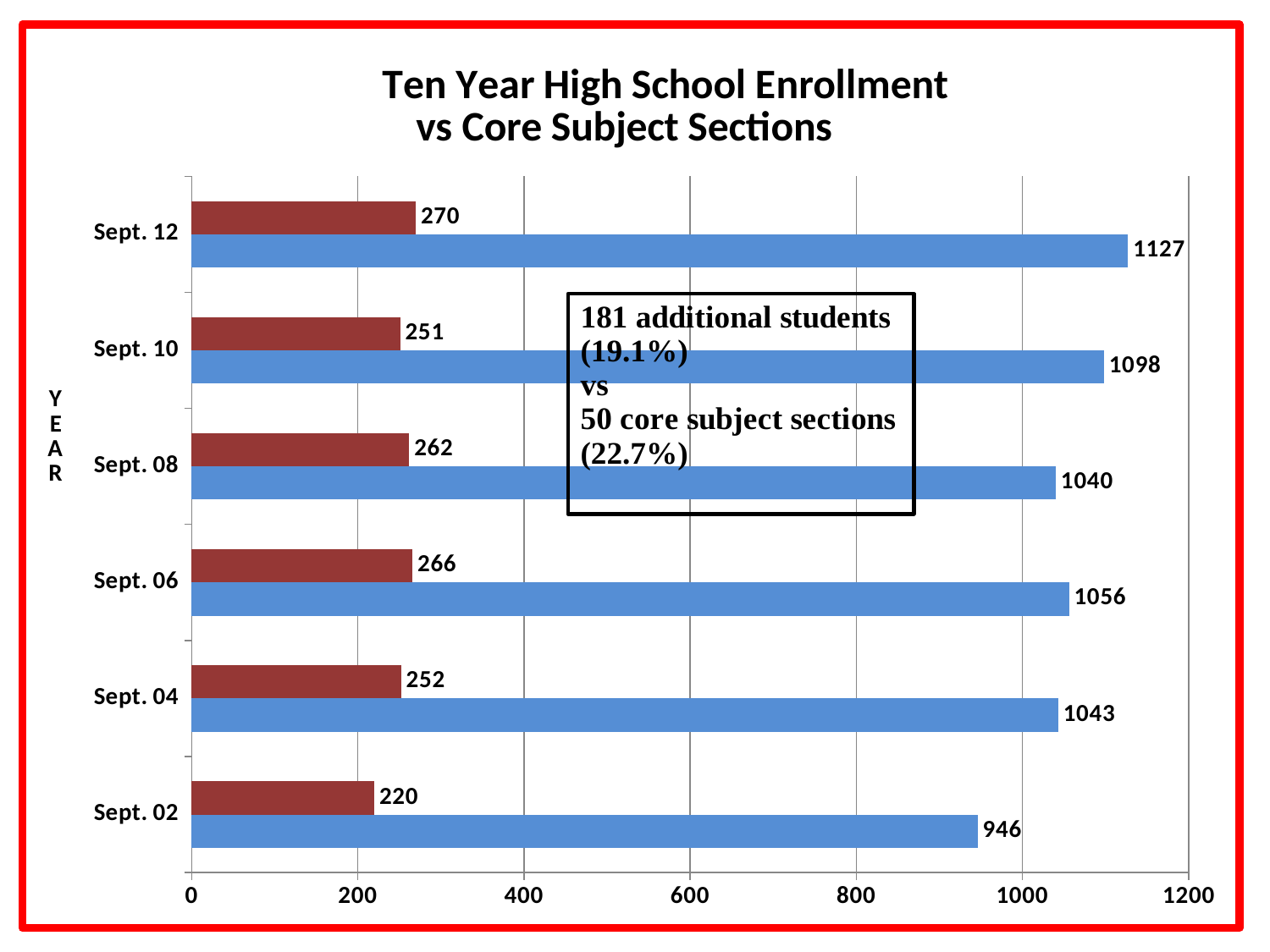
How many years are shown on the chart? 6 What is the difference between the blue bar values for Sept. 12 and Sept. 02? 181 What is the value of the blue bar for Sept. 04? 1043 What is the value of the blue bar for Sept. 12? 1127 Which has the larger blue bar value, Sept. 06 or Sept. 04? Sept. 06 What is the difference between the red bar values for Sept. 12 and Sept. 02? 50 What is the value of the red bar for Sept. 08? 262 Which year has the lowest blue bar value? Sept. 02 What type of chart is shown on the slide? Bar chart What is the value of the red bar for Sept. 02? 220 Which year has the lowest red bar value? Sept. 02 Which year has the highest blue bar value? Sept. 12